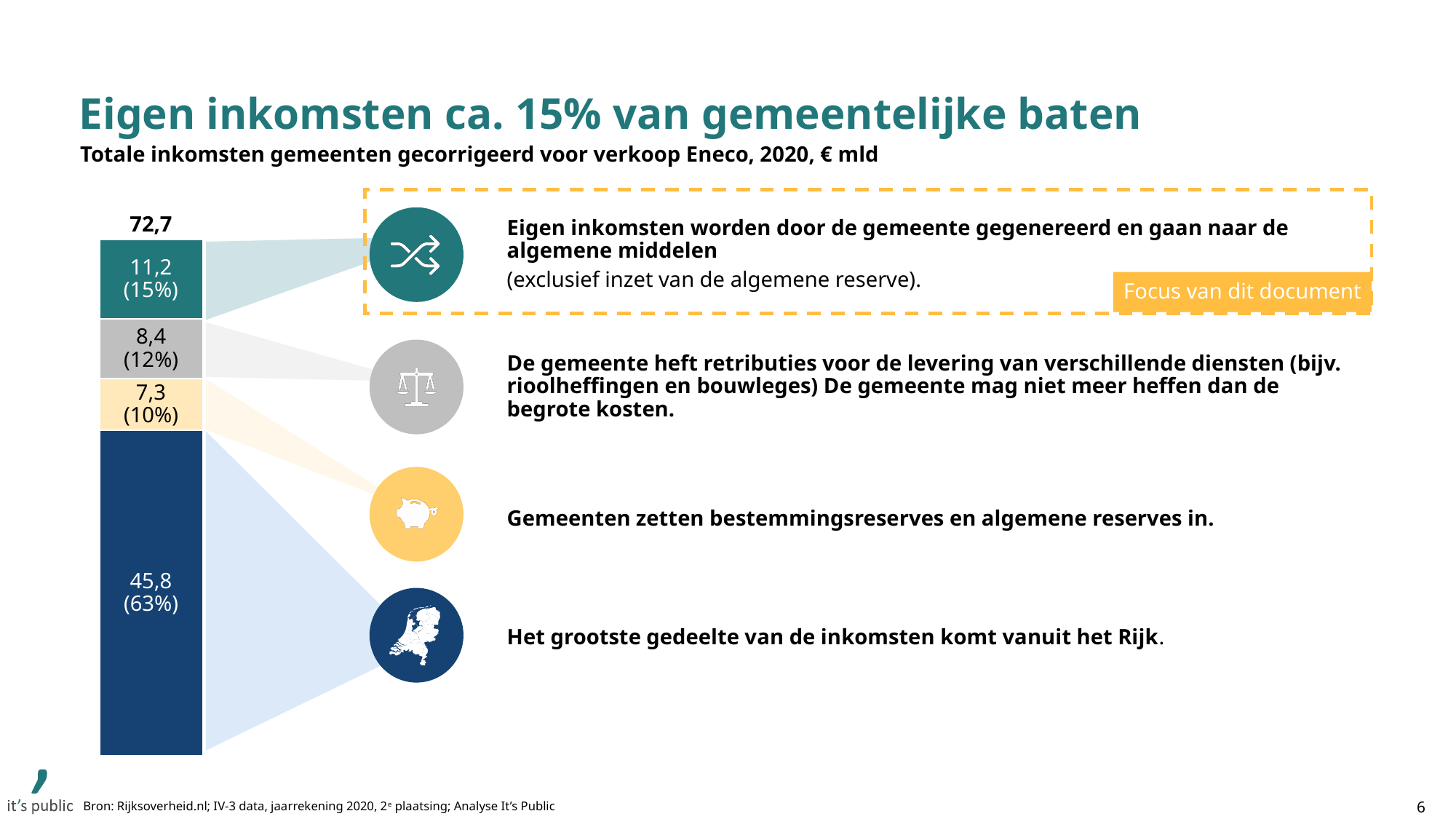
How many segments does the stacked bar have? 4 What kind of chart is shown on the slide? A stacked bar chart What share of the total does the dark blue segment represent, according to its label? 63% Which segment of the stacked bar is the largest? The dark blue segment (45,8, 63%) What value is printed on the teal (top) segment of the stacked bar? 11,2 What value is printed on the yellow segment of the stacked bar? 7,3 Which is larger: the grey segment or the yellow segment? The grey segment (8,4) What is the total value shown at the top of the stacked bar? 72,7 What value is printed on the dark blue (bottom) segment of the stacked bar? 45,8 What percentage is printed on the grey segment of the stacked bar? 12% Which segment of the stacked bar is the smallest? The yellow segment (7,3, 10%) What is the difference between the teal segment (11,2) and the grey segment (8,4)? 2,8